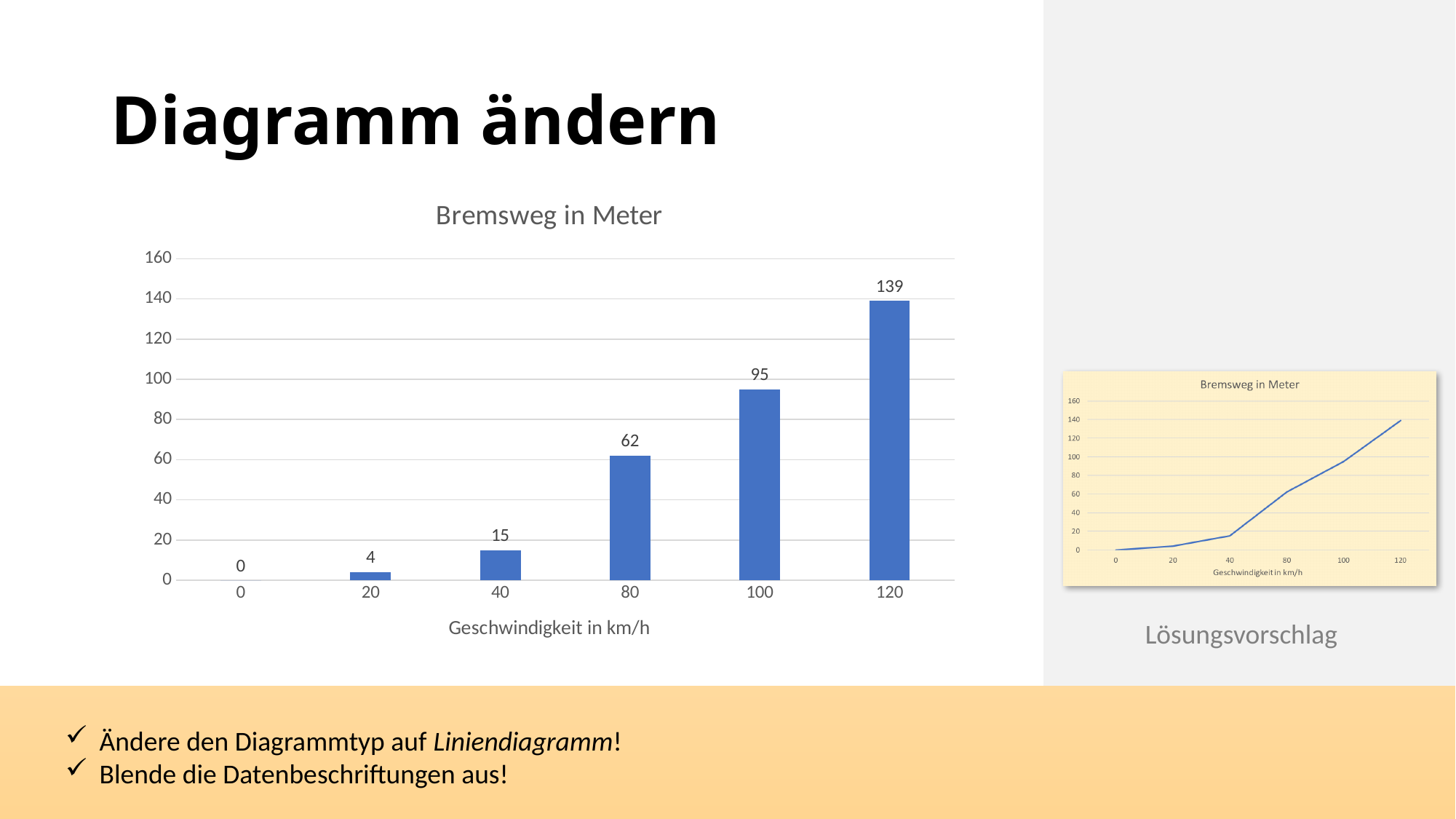
In the large bar chart 'Bremsweg in Meter', what is the value for 40 km/h? 15 In the large bar chart 'Bremsweg in Meter', which speed has the highest braking distance? 120 In the large bar chart 'Bremsweg in Meter', is the value for 100 km/h greater or less than 80? greater What kind of chart is the large chart 'Bremsweg in Meter' on the left of the slide? bar chart In the large bar chart 'Bremsweg in Meter', which speed has the lowest braking distance? 0 In the large bar chart 'Bremsweg in Meter', which is larger: the value for 80 km/h or the value for 100 km/h? 100 km/h In the large bar chart 'Bremsweg in Meter', do the values rise or fall as speed increases along the x axis? rise How many categories are shown on the x axis of the large bar chart 'Bremsweg in Meter'? 6 In the large bar chart 'Bremsweg in Meter', what is the value for 80 km/h? 62 In the large bar chart 'Bremsweg in Meter', what is the difference between the values for 120 km/h and 100 km/h? 44 In the large bar chart 'Bremsweg in Meter', what is the value for 120 km/h? 139 What is the x-axis title of the large bar chart 'Bremsweg in Meter'? Geschwindigkeit in km/h